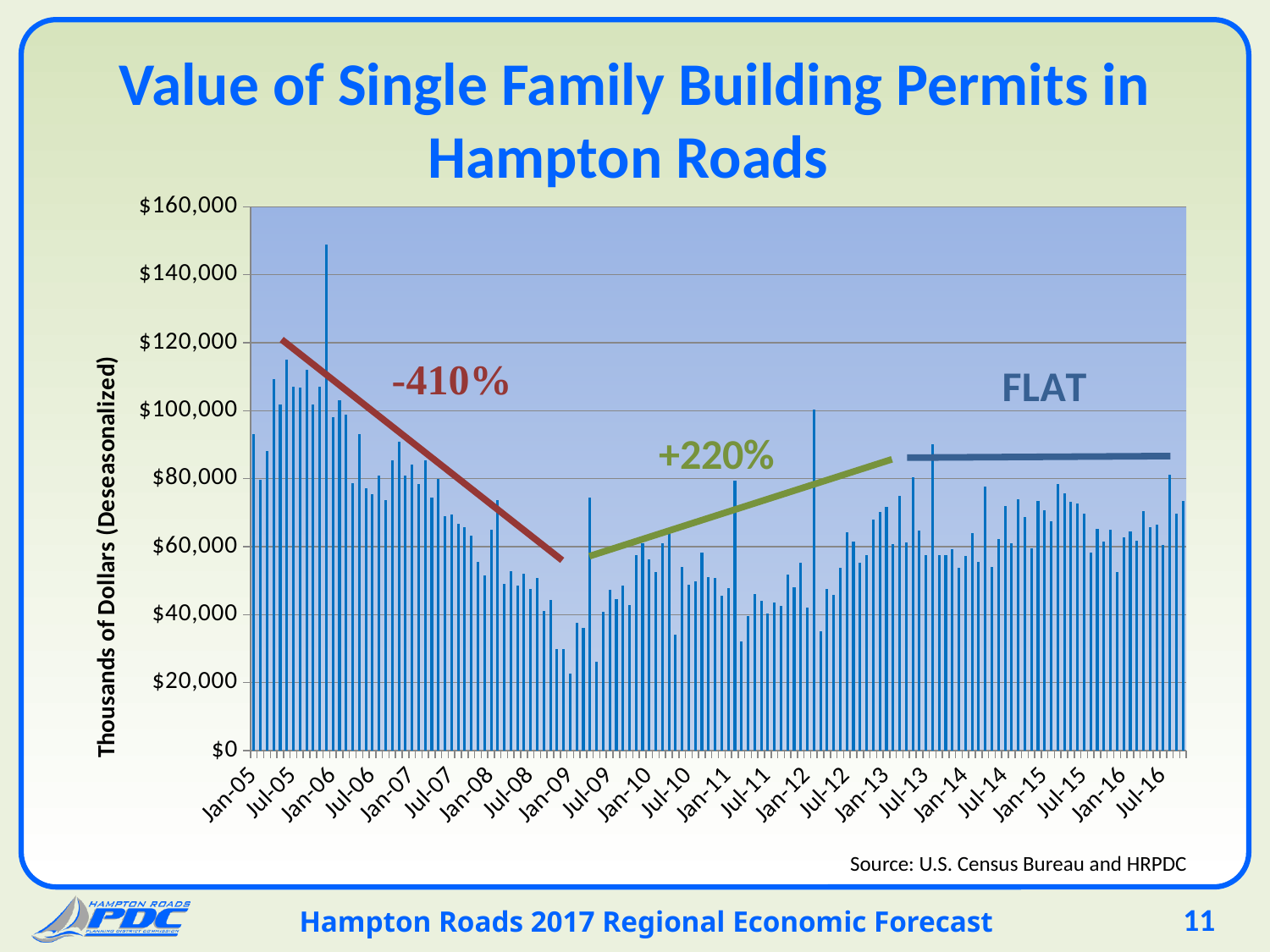
What percentage change is labeled on the declining trend line at the left of the chart? -410% Is the value for Jul-05 greater or less than $100,000? greater Is the value for Jan-13 greater or less than $40,000? greater Do the values generally rise or fall between Jan-05 and Jan-09? fall Is the value for Jan-05 greater or less than $80,000? greater What is the title of the chart? Value of Single Family Building Permits in Hampton Roads Which is larger, the value for Jan-05 or the value for Jan-09? Jan-05 What kind of chart is shown on the slide? bar chart Do the values generally rise or fall between Jan-09 and Jan-13? rise Which is larger, the value for Jul-05 or the value for Jul-08? Jul-05